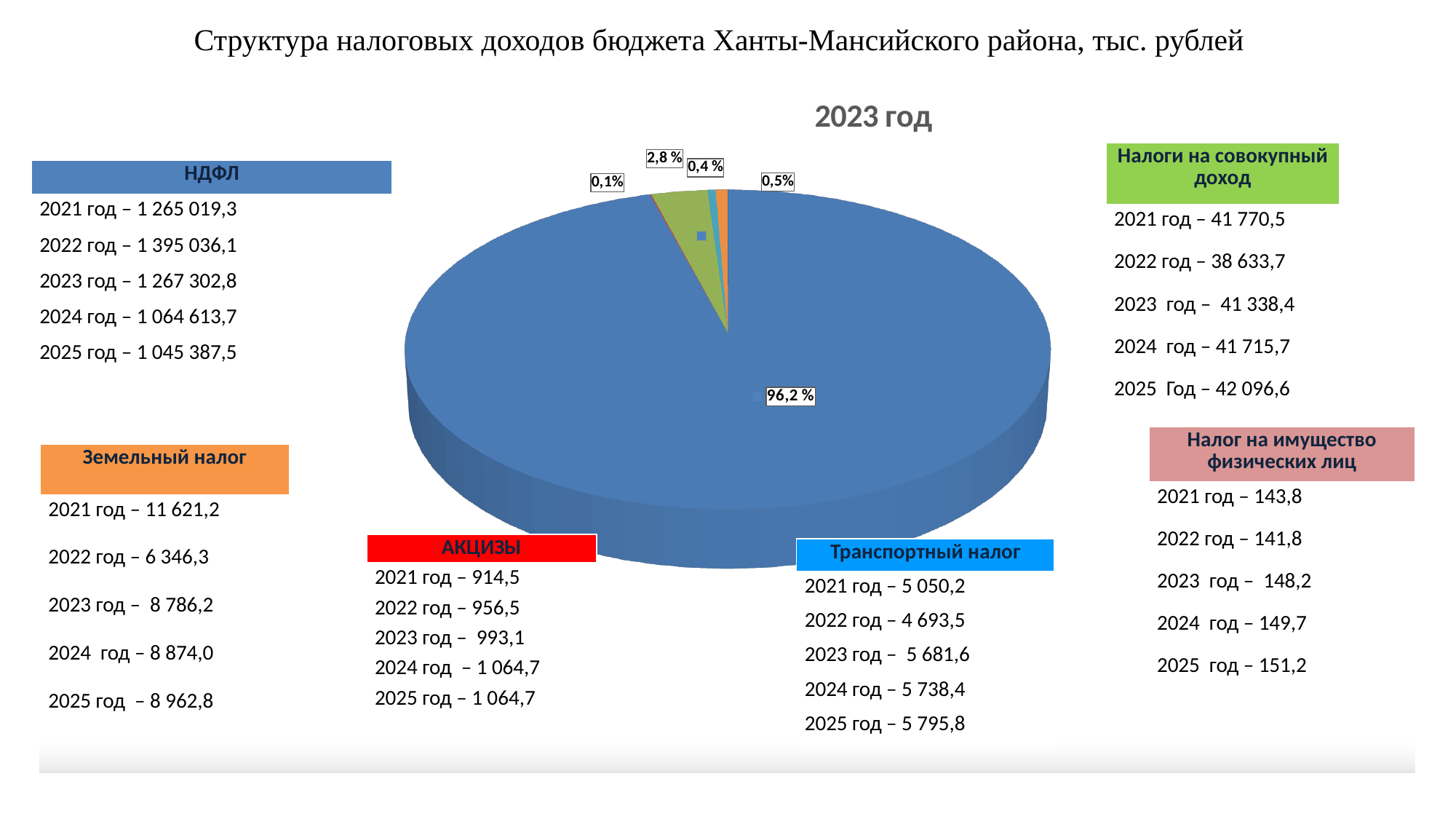
According to the Транспортный налог box on the slide, what is the value for 2025 год? 5 795,8 What is the title shown above the pie chart? 2023 год Which is larger on the pie chart: the slice labelled 2,8 % or the slice labelled 0,5%? 2,8 % What share does the largest slice of the pie chart have? 96,2 % What share is shown for the green slice of the pie chart? 2,8 % Is the share of the largest slice of the pie chart greater or less than 90%? greater According to the Налоги на совокупный доход box on the slide, what is the value for 2023 год? 41 338,4 How many percentage labels are shown on the pie chart? 5 According to the НДФЛ box on the slide, what is the value for 2023 год? 1 267 302,8 What kind of chart is shown on the slide? pie chart What colour is the largest slice of the pie chart? blue What is the smallest percentage label shown on the pie chart? 0,1%